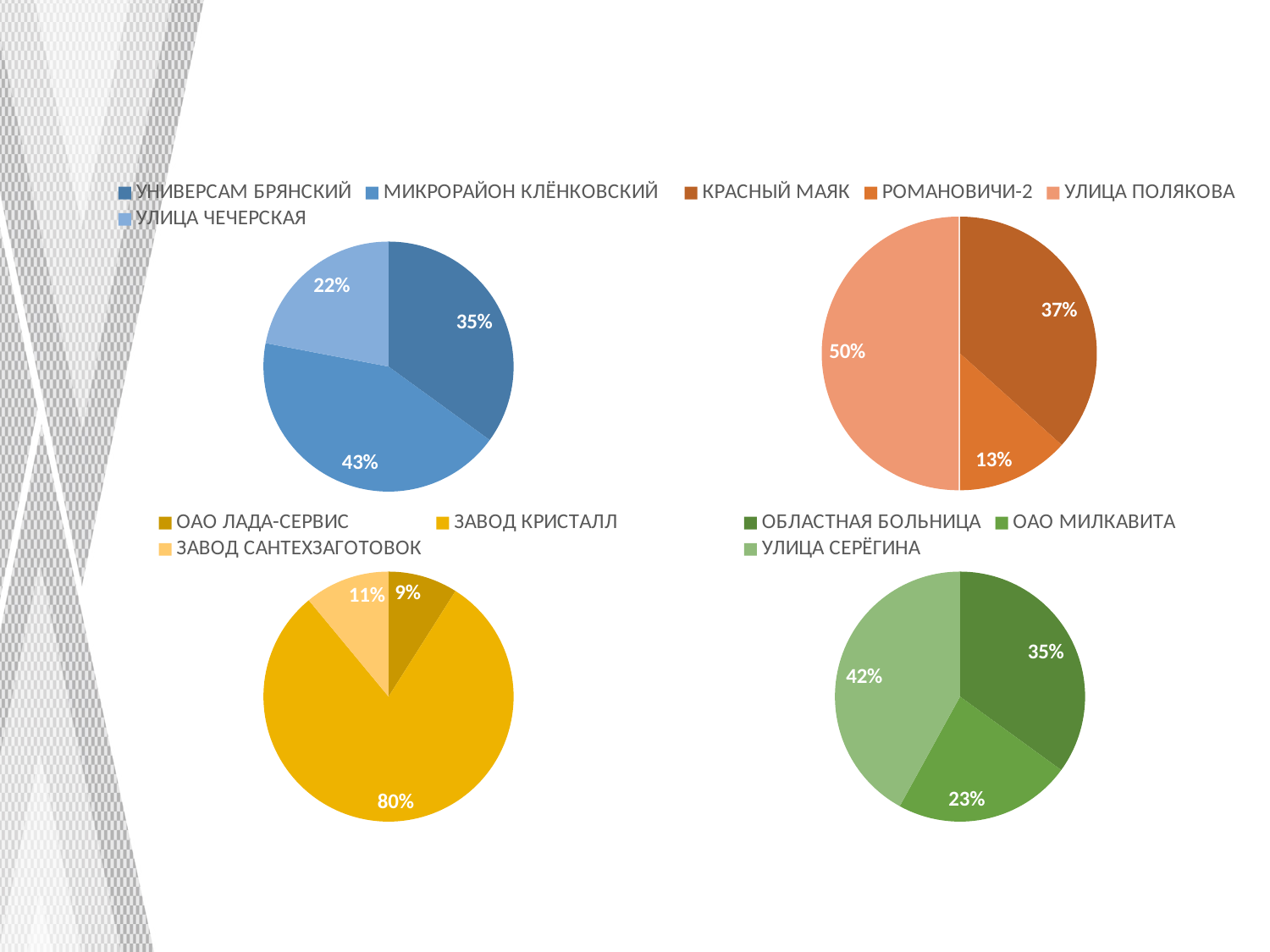
In the top-left pie chart, which category has the smallest slice? УЛИЦА ЧЕЧЕРСКАЯ In the top-right pie chart, what share does УЛИЦА ПОЛЯКОВА have? 50% In the bottom-right pie chart, which is larger: ОБЛАСТНАЯ БОЛЬНИЦА or УЛИЦА СЕРЁГИНА? УЛИЦА СЕРЁГИНА In the top-right pie chart, which category has the largest slice? УЛИЦА ПОЛЯКОВА How many categories does the bottom-right pie chart show? 3 In the bottom-left pie chart, what share does ЗАВОД КРИСТАЛЛ have? 80% In the top-right pie chart, what is the difference between the shares of КРАСНЫЙ МАЯК and РОМАНОВИЧИ-2? 24% In the bottom-left pie chart, which category has the smallest slice? ОАО ЛАДА-СЕРВИС In the top-left pie chart, what share does МИКРОРАЙОН КЛЁНКОВСКИЙ have? 43% How many pie charts are on the slide? 4 What type of chart is the top-left chart? Pie chart